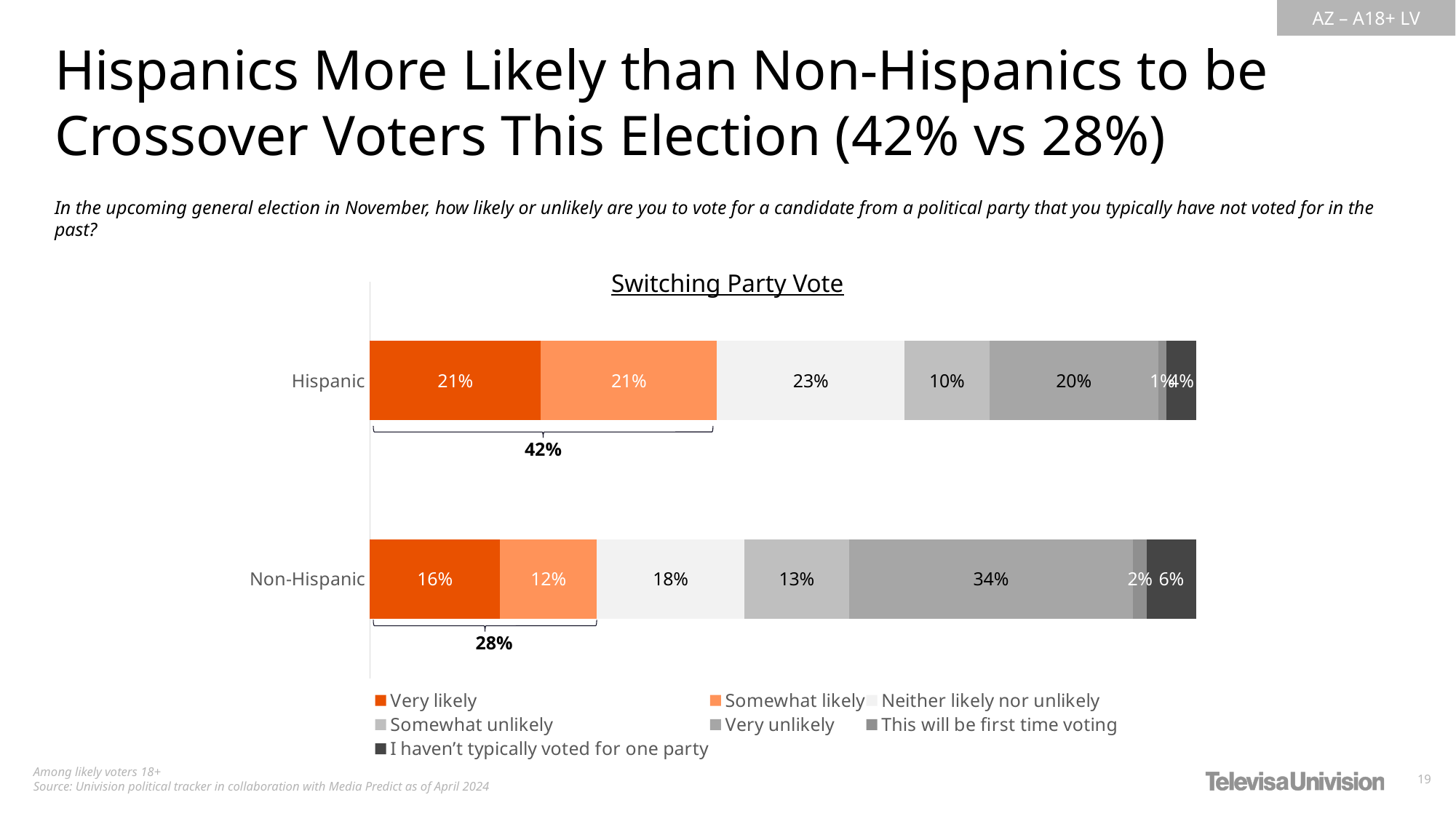
What percentage of Hispanic likely voters say they are very likely to vote for a candidate from a party they typically have not voted for? 21% How many response categories does the legend list? 7 What is the 'Neither likely nor unlikely' value for Non-Hispanic voters? 18% What percentage of Non-Hispanic likely voters say they are very unlikely to switch their party vote? 34% Which response category has the largest share among Non-Hispanic voters? Very unlikely What type of chart is used to show Switching Party Vote? Stacked bar chart What is the difference between the 'Somewhat likely' values for Hispanic and Non-Hispanic voters? 9 percentage points What is the combined 'very likely' plus 'somewhat likely' share shown under the Hispanic bar? 42% Which group has a higher 'Somewhat unlikely' share, Hispanic or Non-Hispanic? Non-Hispanic How many groups (bars) are shown in the Switching Party Vote chart? 2 What is the title of the chart on the slide? Switching Party Vote Which response category has the smallest share among Hispanic voters? This will be first time voting